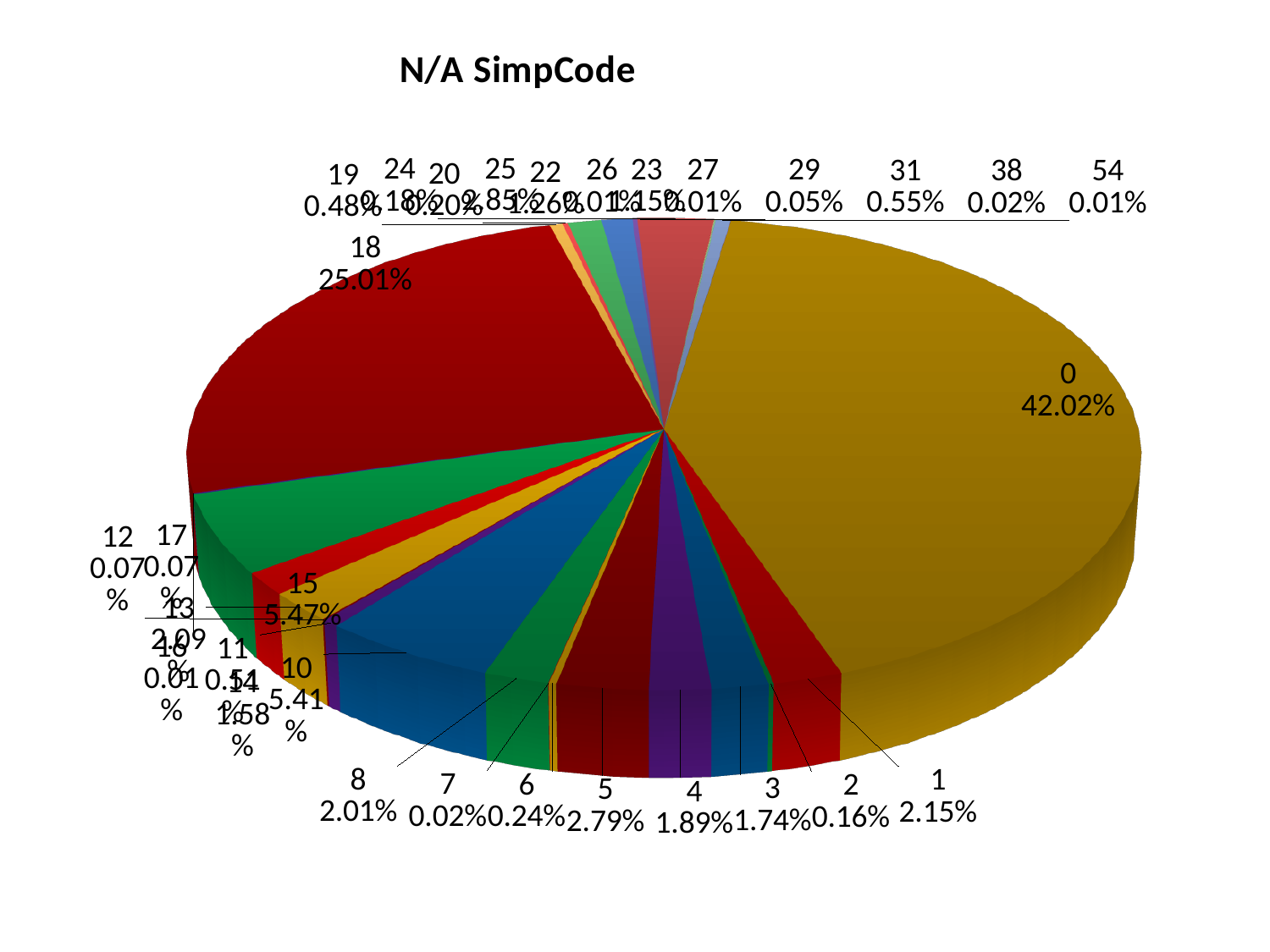
What share of the pie does category 0 have? 42.02% What is the title of the chart? N/A SimpCode What is the value shown for category 31? 0.55% Which category has the largest slice of the pie? 0 What is the value shown for category 15? 5.47% What is the value shown for category 8? 2.01% What is the difference between the shares of category 0 and category 18? 17.01% What is the value shown for category 10? 5.41% What is the value shown for category 5? 2.79% What kind of chart is shown on the slide? pie chart What share of the pie does category 18 have? 25.01% Which has the larger share, category 5 or category 1? 5